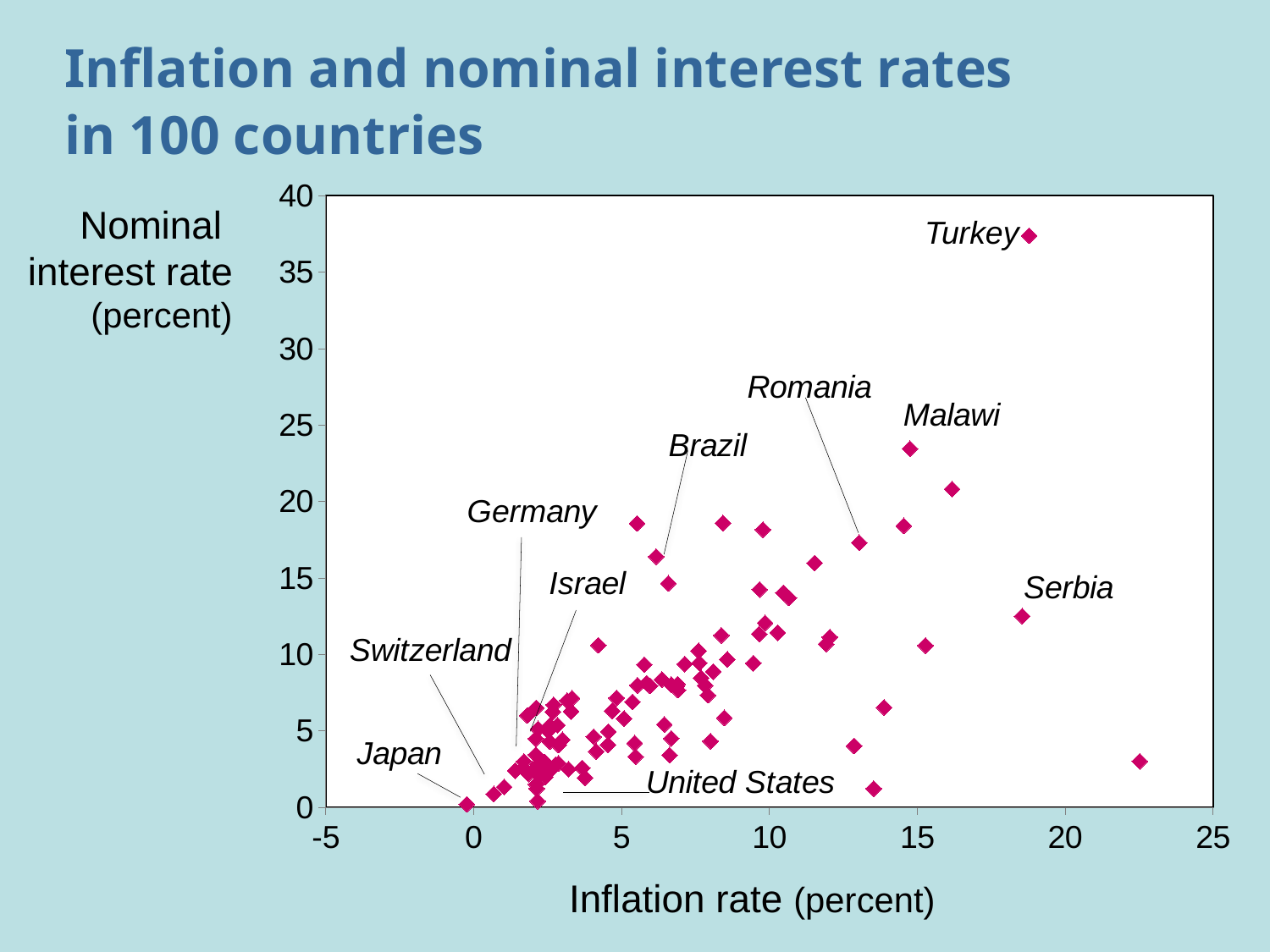
What is the title of the chart? Inflation and nominal interest rates in 100 countries Which labeled country has the lowest nominal interest rate? Japan Is the nominal interest rate for Turkey greater or less than 35? greater What variable is plotted on the horizontal axis? Inflation rate (percent) As the inflation rate increases along the x axis, do nominal interest rates generally rise or fall? Rise Which has the higher nominal interest rate, Malawi or Serbia? Malawi Is the inflation rate for Serbia greater or less than 15? greater Is the inflation rate for Japan greater or less than 5? less According to the chart title, how many countries are plotted? 100 Which labeled country has the highest nominal interest rate? Turkey What kind of chart is shown on the slide? Scatter plot